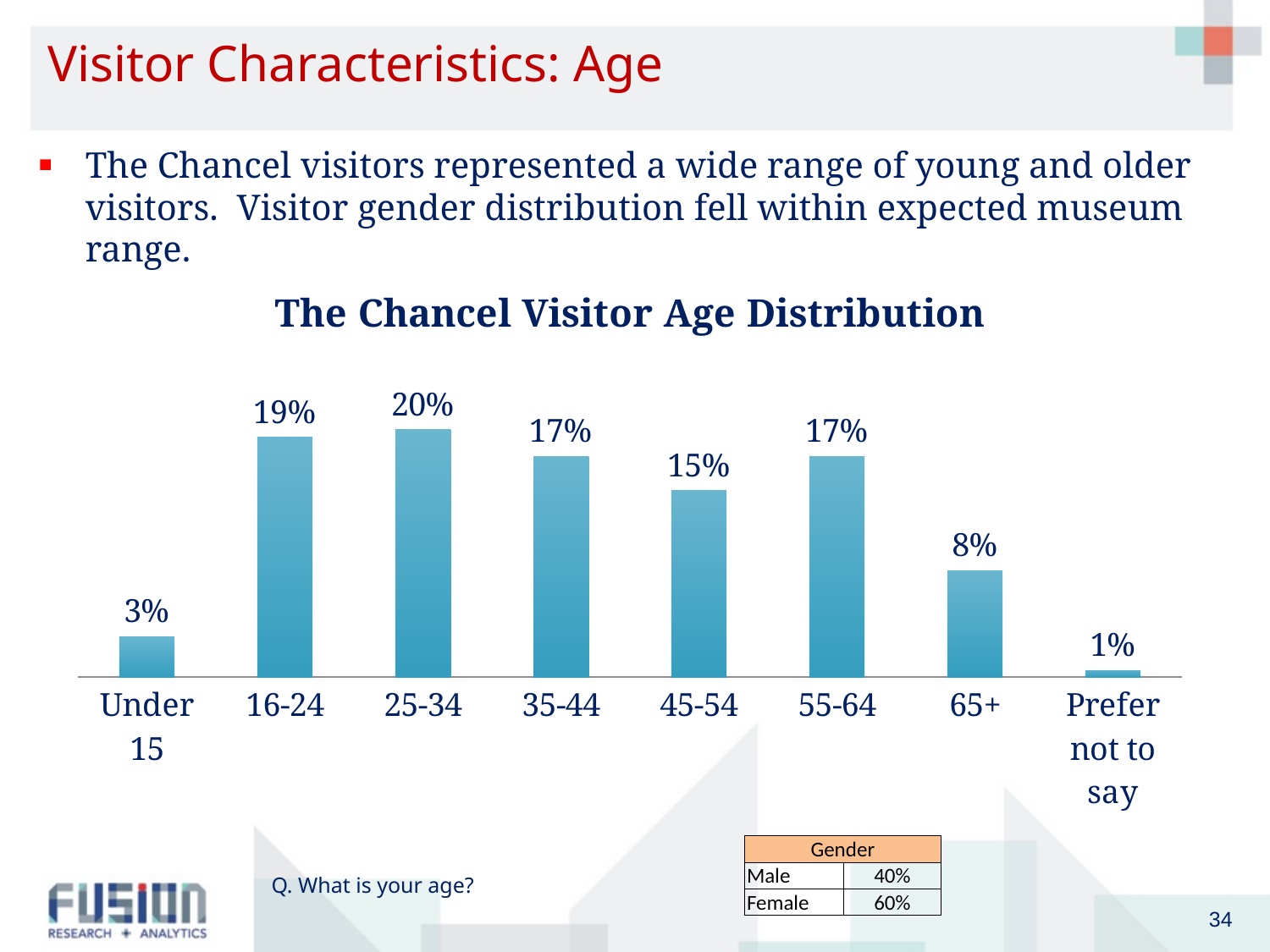
Which age category has the lowest share of visitors? Prefer not to say What is the difference in percentage points between the 16-24 and 45-54 age groups? 4 How many age categories are shown on the x axis of the chart? 8 What percentage of visitors were Under 15? 3% What percentage of Chancel visitors were aged 65+? 8% Which age group has the highest share of visitors? 25-34 Which is larger, the share of visitors aged 55-64 or aged 65+? 55-64 What percentage of Chancel visitors were aged 25-34? 20% What type of chart is used to show the visitor age distribution? Bar chart What is the combined percentage of visitors aged 16-24 and 25-34? 39% What is the title of the chart? The Chancel Visitor Age Distribution What percentage of visitors were aged 35-44? 17%